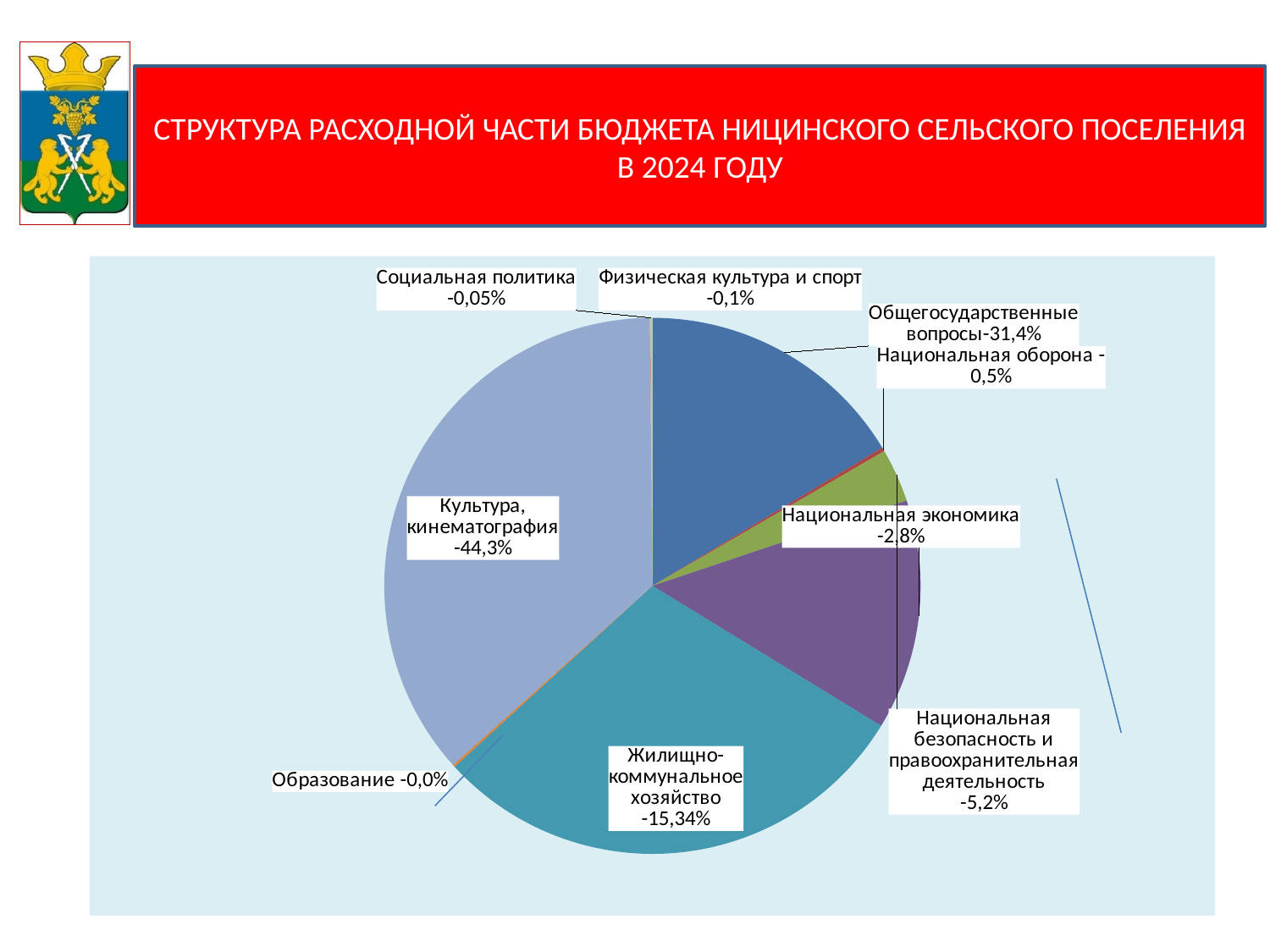
What share is shown for Национальная экономика? 2,8% How many categories are shown in the pie chart? 9 Which is larger: the share for Общегосударственные вопросы or the share for Жилищно-коммунальное хозяйство? Общегосударственные вопросы What share is shown for Жилищно-коммунальное хозяйство? 15,34% What kind of chart is shown on the slide? pie chart Which category has the smallest share of the pie? Образование What share is shown for Национальная оборона? 0,5% What is the difference between the shares for Культура, кинематография and Общегосударственные вопросы? 12,9% What share is shown for Общегосударственные вопросы? 31,4% Which category has the largest share of the pie? Культура, кинематография What share of the budget expenditure goes to Культура, кинематография? 44,3% What share is shown for Национальная безопасность и правоохранительная деятельность? 5,2%